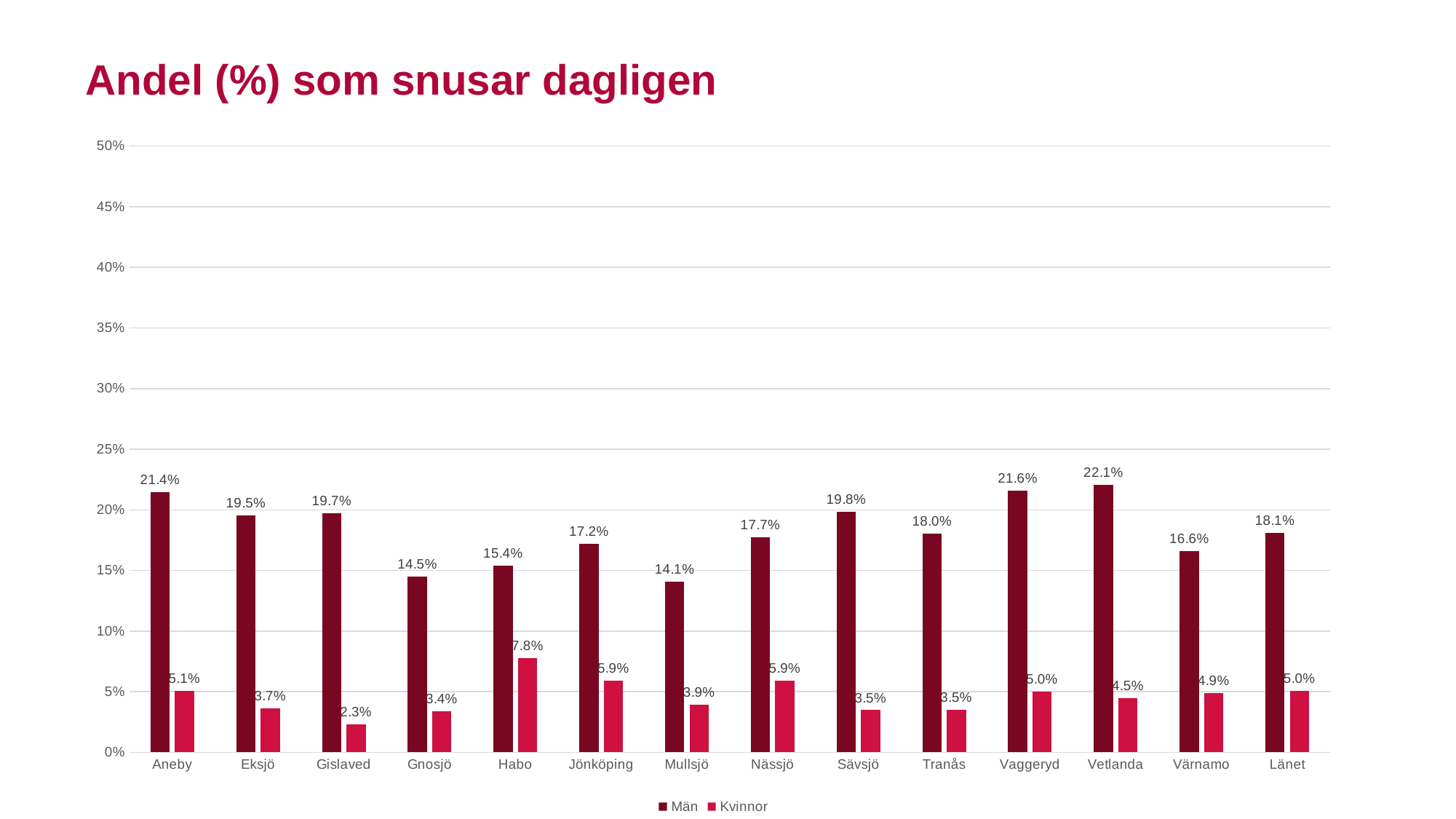
How many categories are shown on the x axis? 14 How many series does the legend list? 2 What is the difference between the Män and Kvinnor values in Aneby? 16.3% Which category has the lowest value for Män? Mullsjö Which is larger, the Män value for Eksjö or the Män value for Gislaved? Gislaved Which category has the highest value for Män? Vetlanda What is the value for Män in Länet? 18.1% What kind of chart is shown on the slide? Bar chart What is the value for Kvinnor in Habo? 7.8% Which category has the lowest value for Kvinnor? Gislaved What is the title of the chart? Andel (%) som snusar dagligen What is the value for Män in Vetlanda? 22.1%